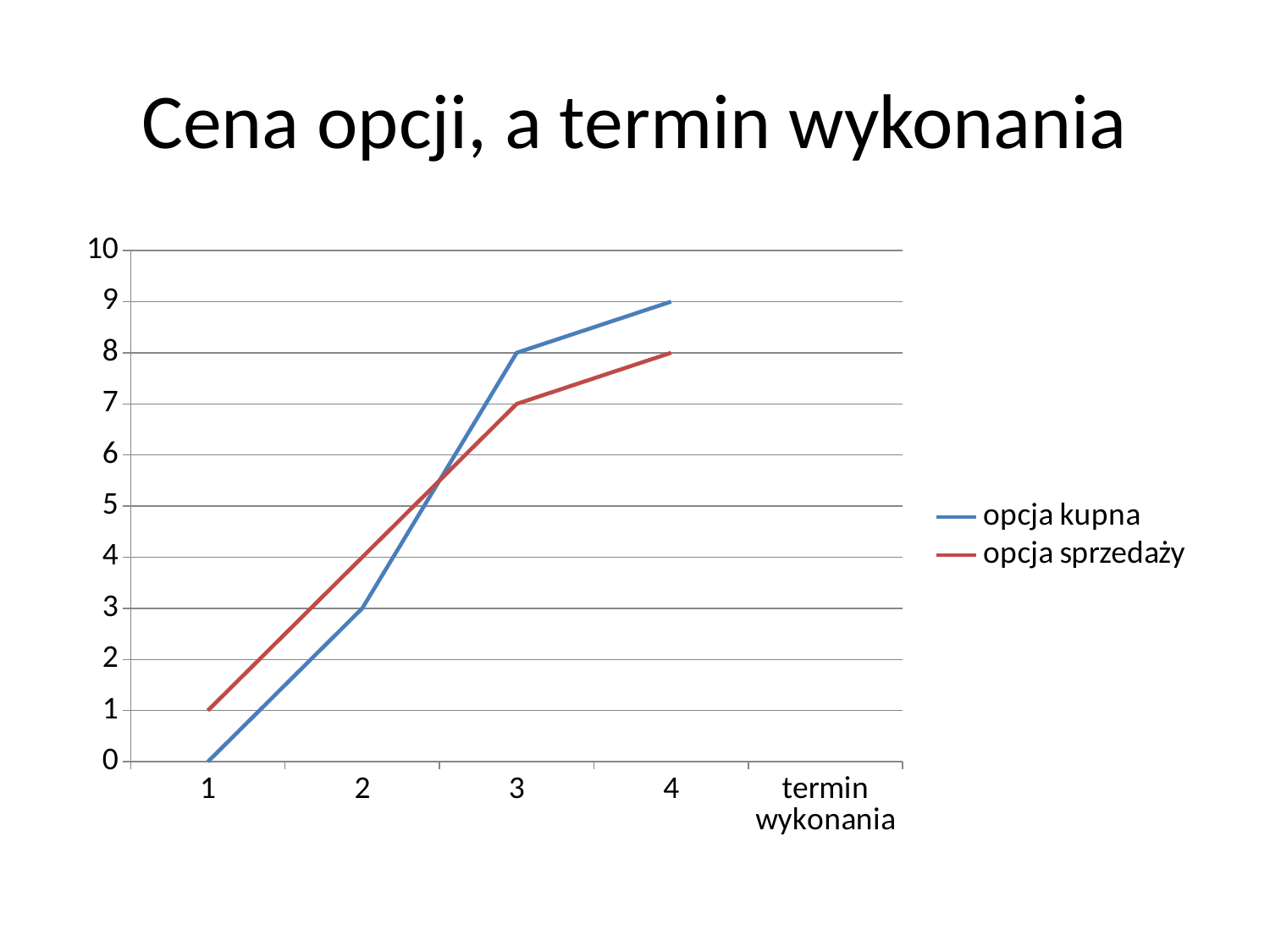
What is the value of opcja kupna at termin wykonania 1? 0 Which series has the higher value at termin wykonania 4? opcja kupna What is the title of the chart on the slide? Cena opcji, a termin wykonania What kind of chart is shown on the slide? line chart What is the value of opcja sprzedaży at termin wykonania 4? 8 Which series has the higher value at termin wykonania 2? opcja sprzedaży At which termin wykonania does opcja kupna reach its highest value? 4 What is the value of opcja sprzedaży at termin wykonania 1? 1 How many series does the legend list? 2 What is the difference between opcja kupna and opcja sprzedaży at termin wykonania 3? 1 Do the values of opcja kupna rise or fall as termin wykonania increases from 1 to 4? rise What is the value of opcja kupna at termin wykonania 3? 8